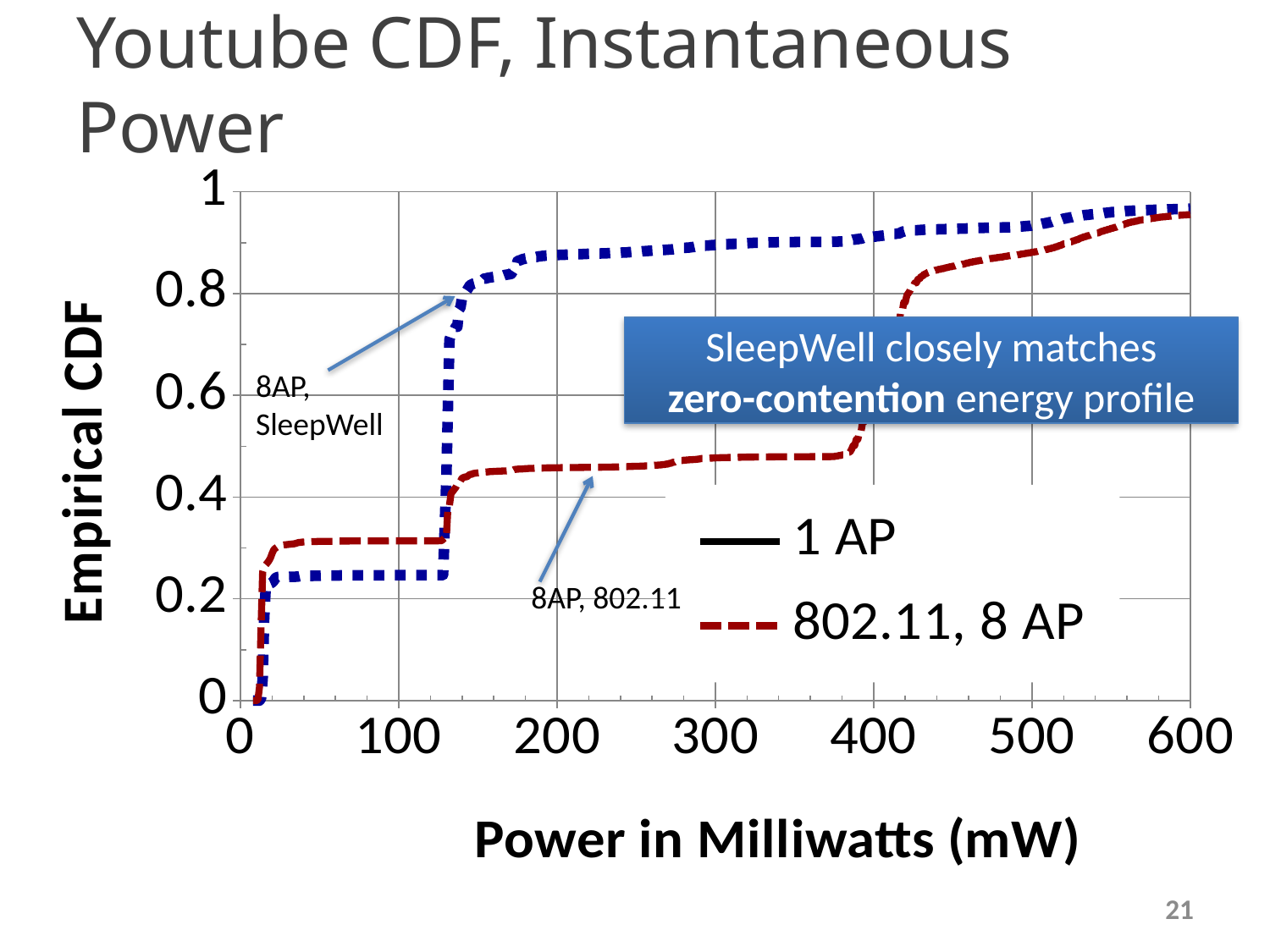
What is the maximum value shown on the x axis? 600 What is the title of the chart on this slide? Youtube CDF, Instantaneous Power Is the empirical CDF of the 8AP, SleepWell curve at 300 mW greater or less than 0.8? greater Is the empirical CDF of the 802.11, 8 AP curve at 300 mW greater or less than 0.6? less What is the label of the x axis? Power in Milliwatts (mW) Is the empirical CDF of the 8AP, SleepWell curve at 500 mW greater or less than 0.8? greater At 50 mW, which curve has the higher empirical CDF, 8AP SleepWell or 802.11 8 AP? 802.11, 8 AP What kind of chart is shown on the slide? line chart Do the curves rise or fall as power increases along the x axis? rise At 300 mW, which curve has the higher empirical CDF, 8AP SleepWell or 802.11 8 AP? 8AP, SleepWell How many series does the chart's legend list? 2